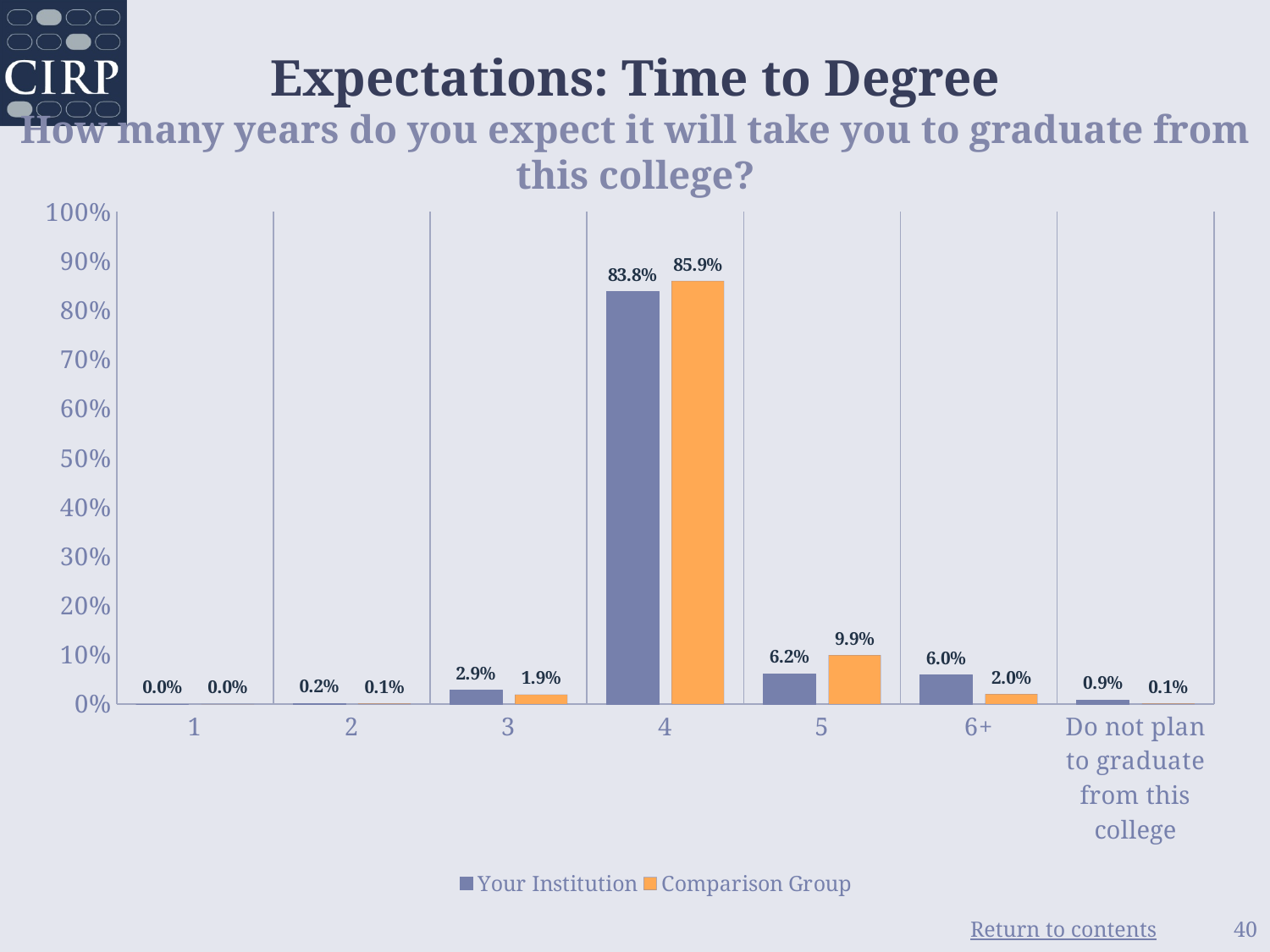
For the category 3, which series has the larger value, Your Institution or Comparison Group? Your Institution Is the value for Your Institution for the category 4 greater or less than 80%? greater What is the value for Your Institution for the category 6+? 6.0% What is the difference between the Comparison Group and Your Institution values for the category 4? 2.1% How many categories are shown on the x axis? 7 What kind of chart is shown on the slide? Bar chart Which category has the highest value for Comparison Group? 4 How many series does the legend list? 2 What is the value for Comparison Group for 'Do not plan to graduate from this college'? 0.1% What is the value for Comparison Group for the category 5? 9.9% What is the difference between the Comparison Group and Your Institution values for the category 5? 3.7% What is the value for Your Institution for the category 4? 83.8%